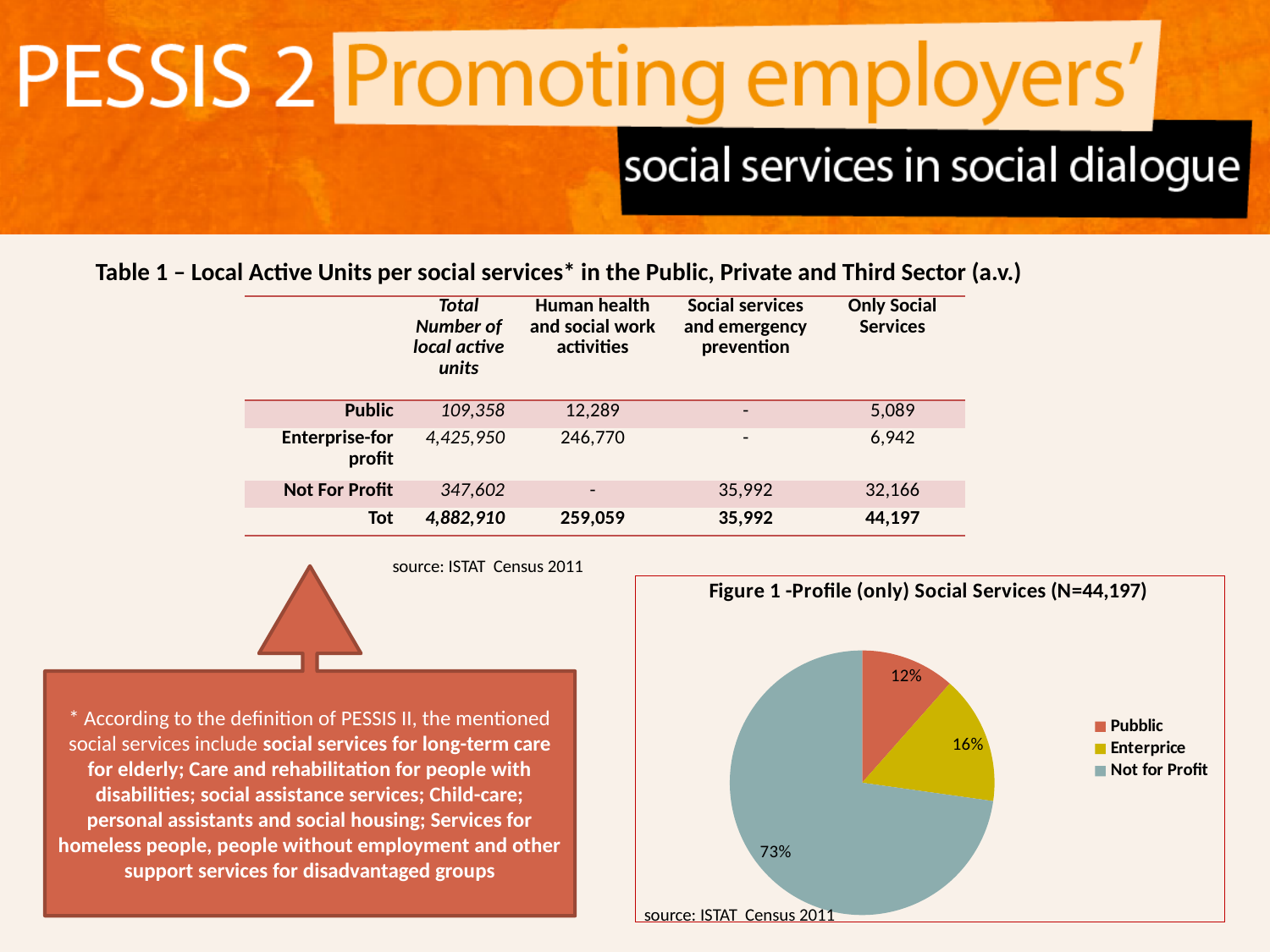
What is the difference in percentage points between the Enterprice slice and the Pubblic slice in the pie chart? 4 What type of chart is Figure 1 - Profile (only) Social Services? pie chart In the pie chart, what share is shown for Pubblic? 12% What is the difference in percentage points between the Not for Profit slice and the Enterprice slice in the pie chart? 57 What colour is the Not for Profit slice in the pie chart? teal/blue-grey In the pie chart, which is larger: the Enterprice slice or the Pubblic slice? Enterprice In the pie chart, what share is shown for Enterprice? 16% Which slice of the pie chart is the largest? Not for Profit In the pie chart, what share is shown for Not for Profit? 73% What is the title of the pie chart? Figure 1 -Profile (only) Social Services (N=44,197) Which slice of the pie chart is the smallest? Pubblic How many slices does the pie chart have? 3